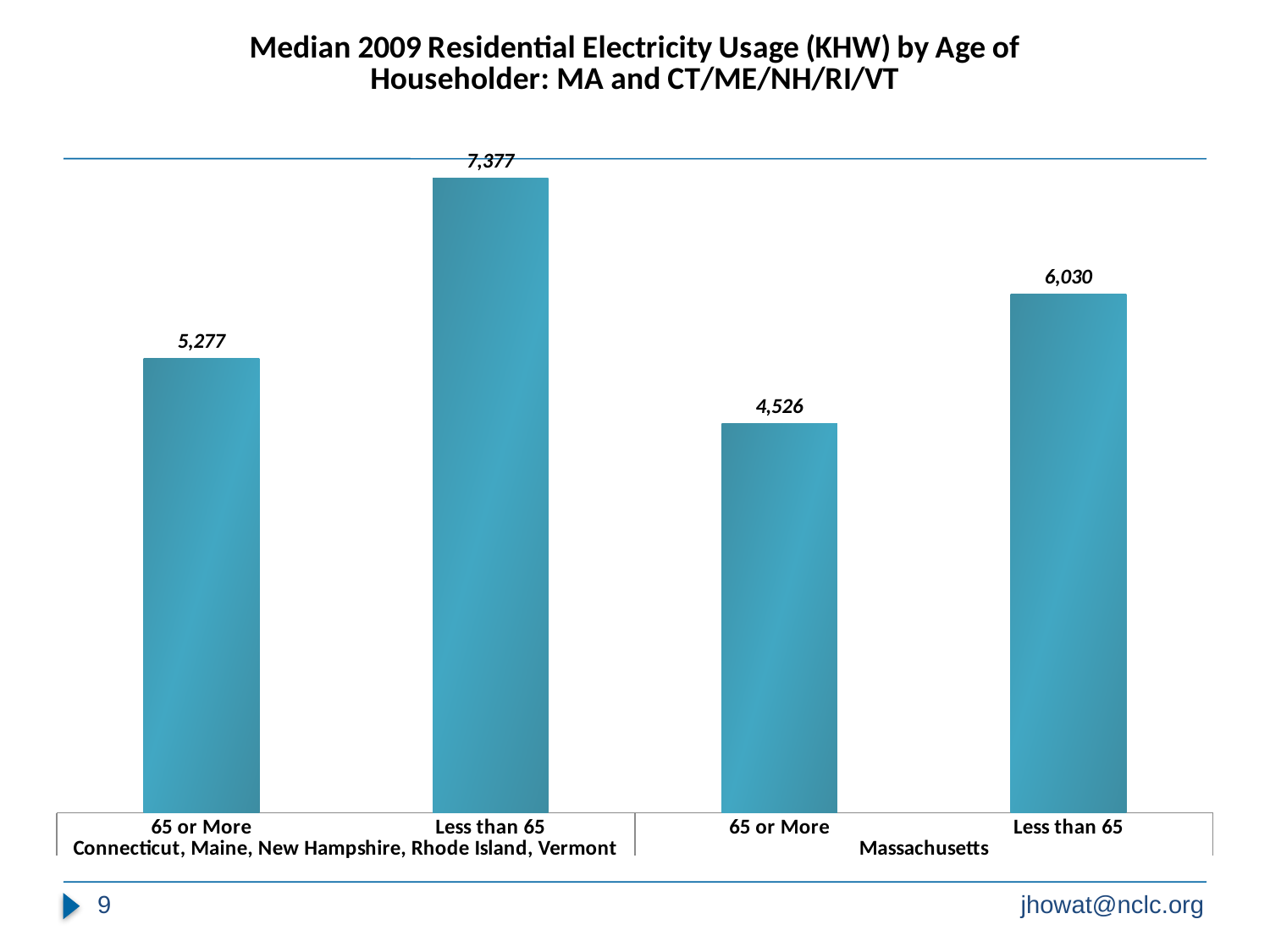
How many bars are plotted on the chart? 4 What kind of chart is shown on the slide? Bar chart What is the difference between the Less than 65 and 65 or More values for Massachusetts? 1,504 What is the median 2009 residential electricity usage for householders Less than 65 in Connecticut, Maine, New Hampshire, Rhode Island, Vermont? 7,377 What is the difference between the Less than 65 and 65 or More values for Connecticut, Maine, New Hampshire, Rhode Island, Vermont? 2,100 What is the median 2009 residential electricity usage for householders 65 or More in Massachusetts? 4,526 What is the median 2009 residential electricity usage for householders 65 or More in Connecticut, Maine, New Hampshire, Rhode Island, Vermont? 5,277 What is the median 2009 residential electricity usage for householders Less than 65 in Massachusetts? 6,030 Which bar has the lowest value on the chart? 65 or More, Massachusetts Which is larger: the 65 or More value for Massachusetts or the 65 or More value for Connecticut, Maine, New Hampshire, Rhode Island, Vermont? Connecticut, Maine, New Hampshire, Rhode Island, Vermont What is the title of the chart? Median 2009 Residential Electricity Usage (KHW) by Age of Householder: MA and CT/ME/NH/RI/VT Which bar has the highest value on the chart? Less than 65, Connecticut, Maine, New Hampshire, Rhode Island, Vermont